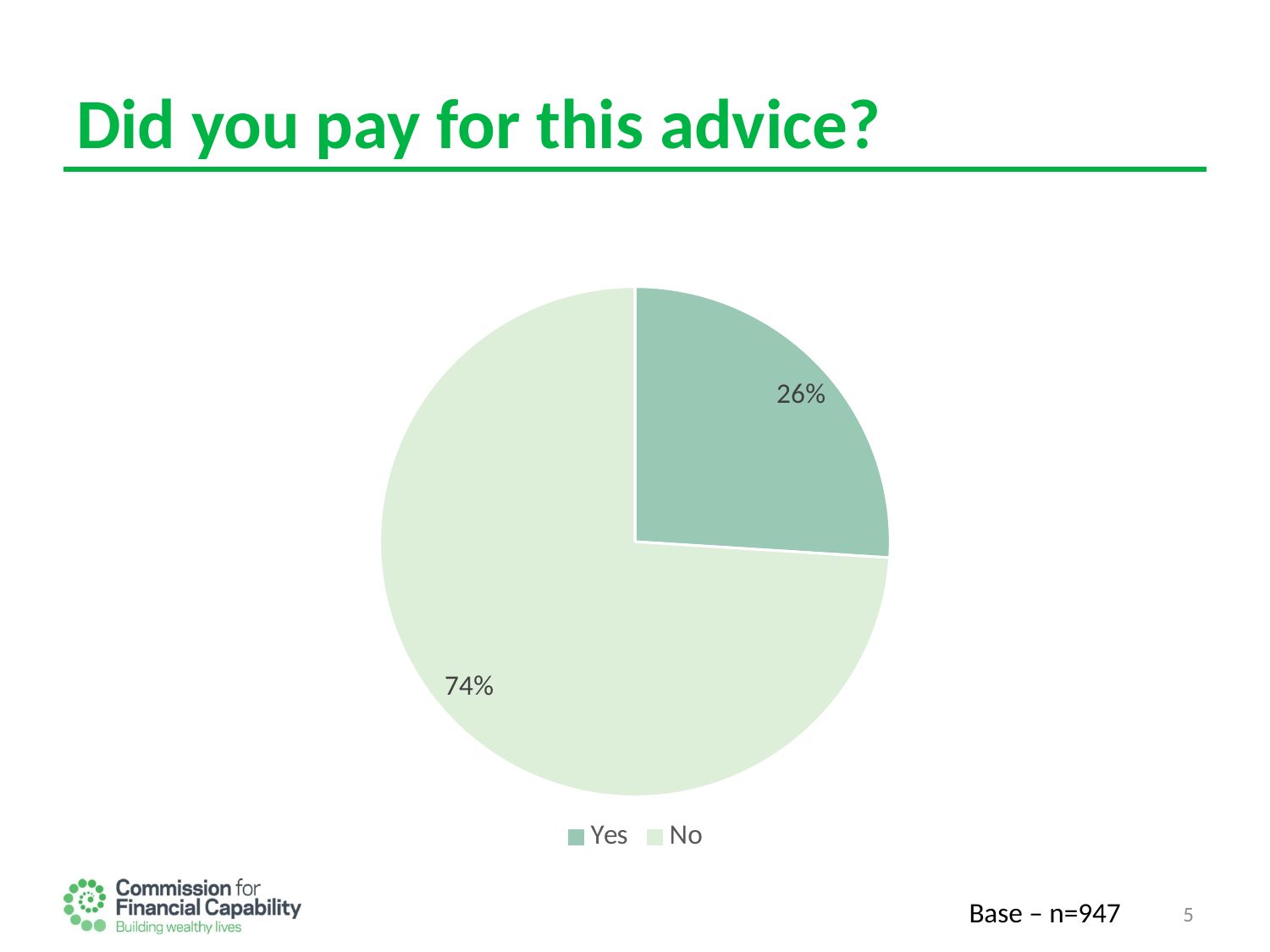
What kind of chart is shown on the slide? pie chart Which response has the largest share of the pie? No What is the difference in percentage points between the "No" and "Yes" slices? 48 What is the title of the slide containing the chart? Did you pay for this advice? How many entries does the legend list? 2 What share of the pie does the "No" slice represent? 74% What is the base sample size shown on the slide? n=947 Which response has the smallest share of the pie? Yes What percentage of respondents answered "No"? 74% How many slices does the pie chart have? 2 Which is larger, the share for "Yes" or the share for "No"? No What percentage of respondents answered "Yes" to paying for the advice? 26%